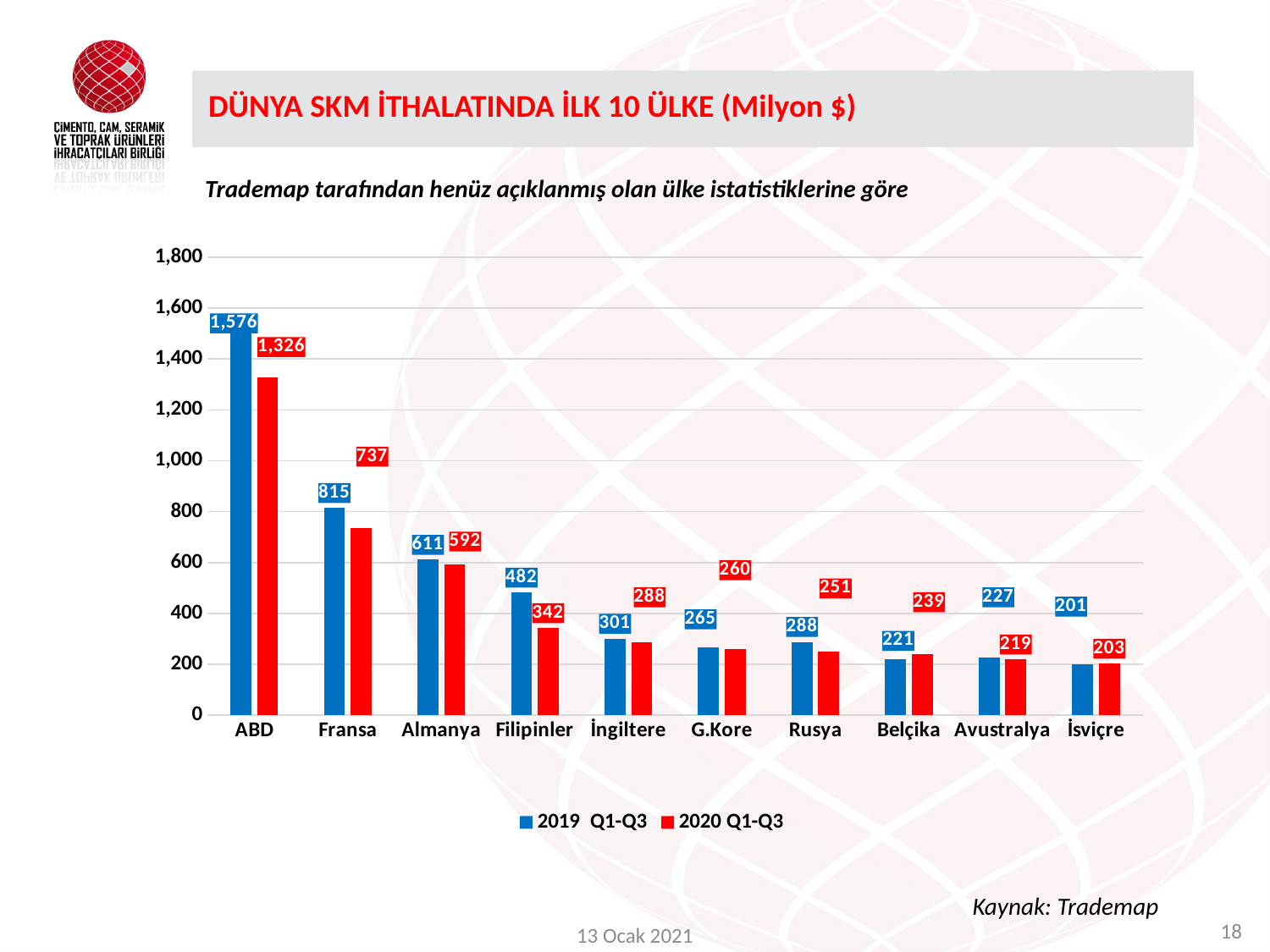
What is the difference between the 2019 Q1-Q3 and 2020 Q1-Q3 values for ABD? 250 Is the 2019 Q1-Q3 value for Almanya greater or less than 600? greater How many countries are shown on the x axis? 10 Which is larger for Belçika: the 2019 Q1-Q3 value or the 2020 Q1-Q3 value? 2020 Q1-Q3 Which country has the lowest 2019 Q1-Q3 value? İsviçre What type of chart is shown on the slide? Bar chart What is the 2020 Q1-Q3 value for Fransa? 737 Which country has the highest 2020 Q1-Q3 value? ABD How many series does the legend list? 2 What is the 2019 Q1-Q3 value for ABD? 1,576 What is the 2020 Q1-Q3 value for Filipinler? 342 What is the 2019 Q1-Q3 value for Rusya? 288